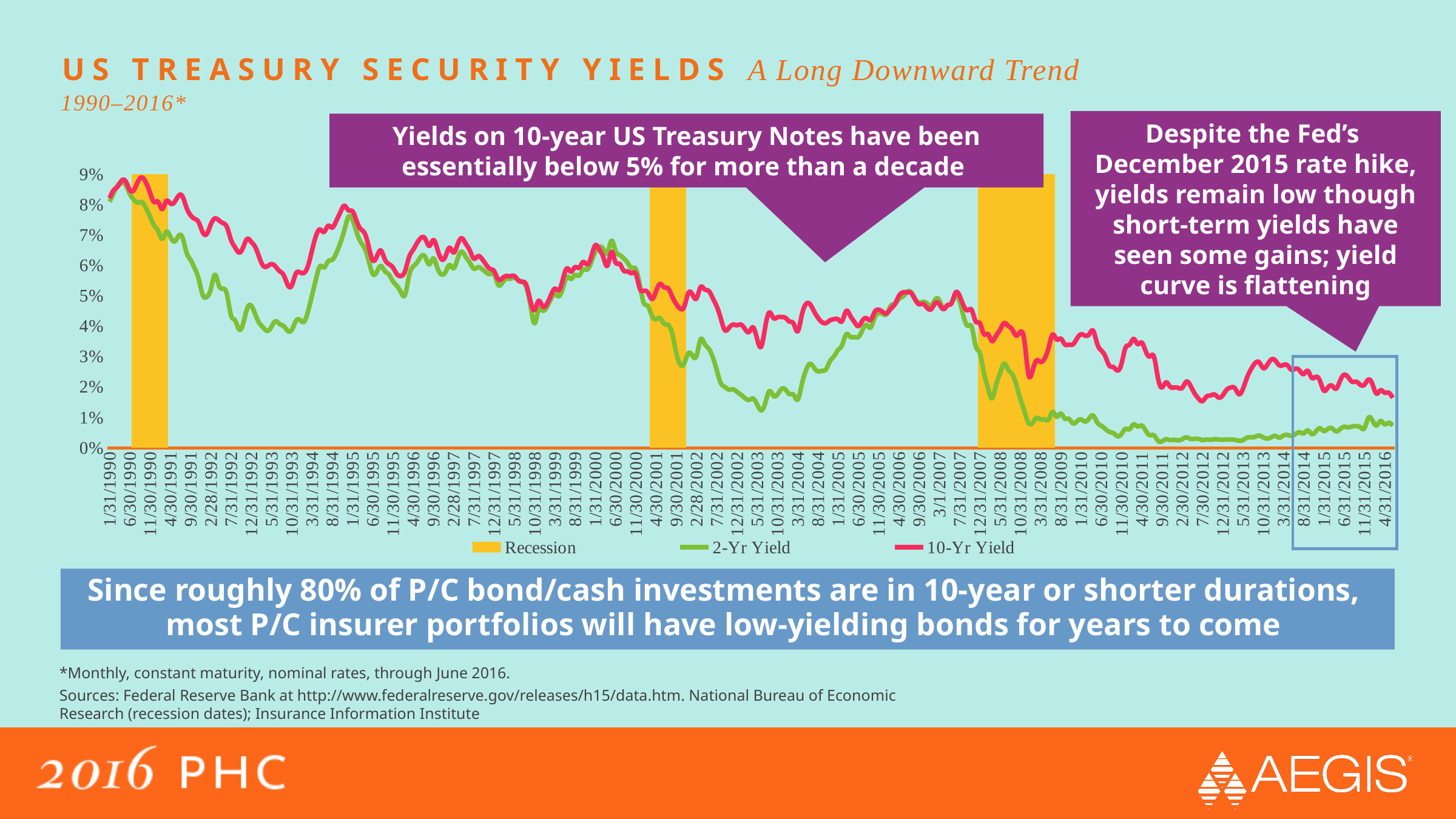
Does the 10-Yr Yield line generally rise or fall from 1990 to 2016? fall What kind of chart is shown on the slide? line chart How many shaded recession periods are shown on the chart? 3 What colour is used for the Recession shading in the chart? yellow Is the 2-Yr Yield at 5/31/2003 greater or less than 2%? less What is the highest value shown on the chart's y axis? 9% Is the 10-Yr Yield at 1/31/1990 greater or less than 7%? greater Is the 2-Yr Yield at 11/30/2011 greater or less than 1%? less How many entries does the chart legend list? 3